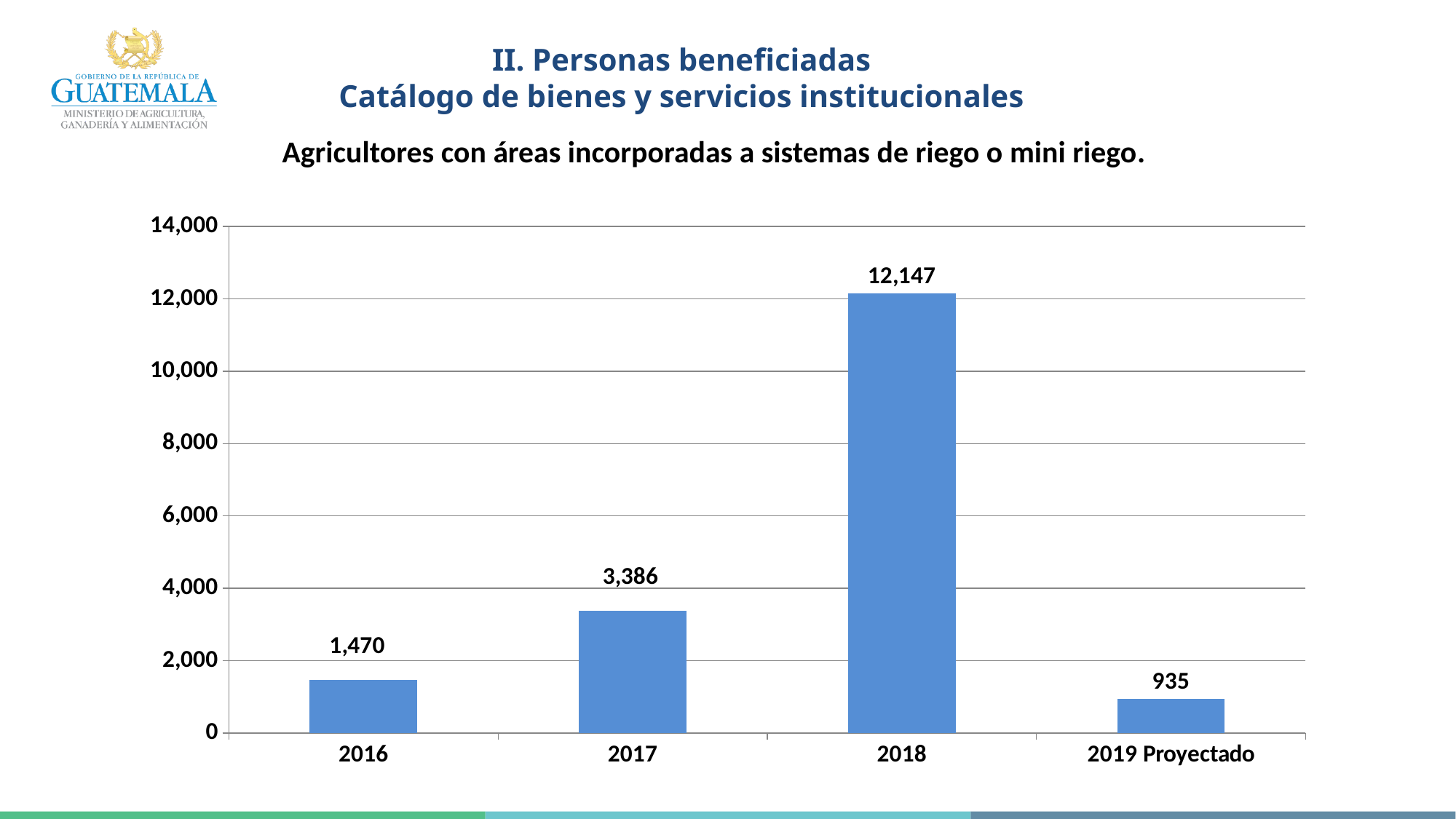
How many categories are shown on the x axis? 4 Which is larger, the value for 2016 or the value for 2017? 2017 Which category has the lowest value? 2019 Proyectado What is the difference between the values for 2016 and 2019 Proyectado? 535 What is the value for 2017? 3,386 Is the value for 2018 greater or less than 12,000? greater What is the value for 2016? 1,470 Which category has the highest value? 2018 What is the difference between the values for 2018 and 2017? 8,761 What is the value for 2019 Proyectado? 935 What kind of chart is shown on the slide? bar chart What is the value for 2018? 12,147